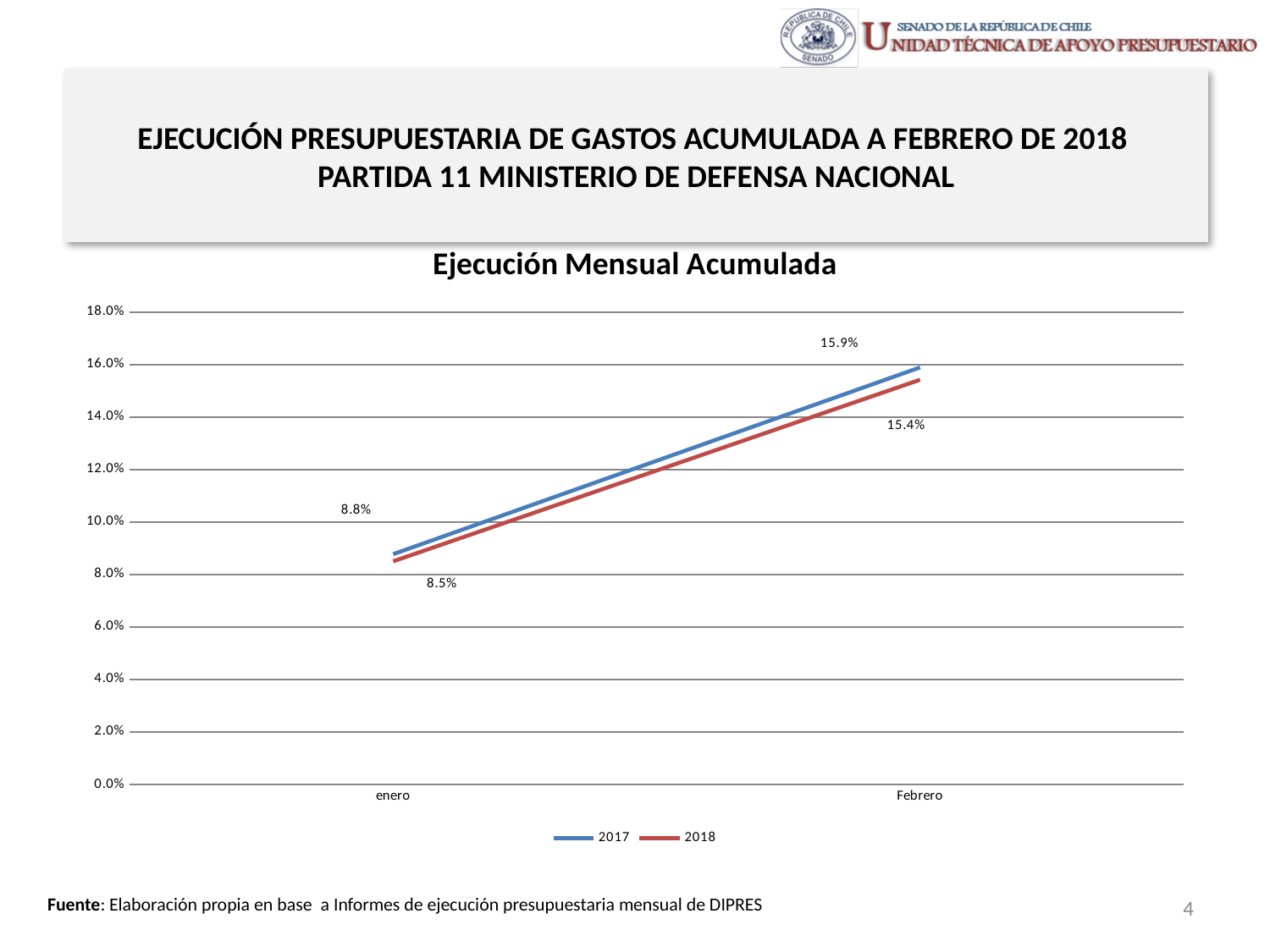
What is the value for 2017 in Febrero? 15.9% What is the difference between the 2017 and 2018 values in Febrero? 0.5% What kind of chart is shown on the slide? line chart What is the chart's title? Ejecución Mensual Acumulada Which series has the higher value in Febrero, 2017 or 2018? 2017 How many categories are shown on the x axis? 2 What is the value for 2017 in enero? 8.8% Which colour is used for the 2018 series? red How many series does the legend list? 2 What is the value for 2018 in Febrero? 15.4% What is the value for 2018 in enero? 8.5% Do the values for 2018 rise or fall from enero to Febrero? rise